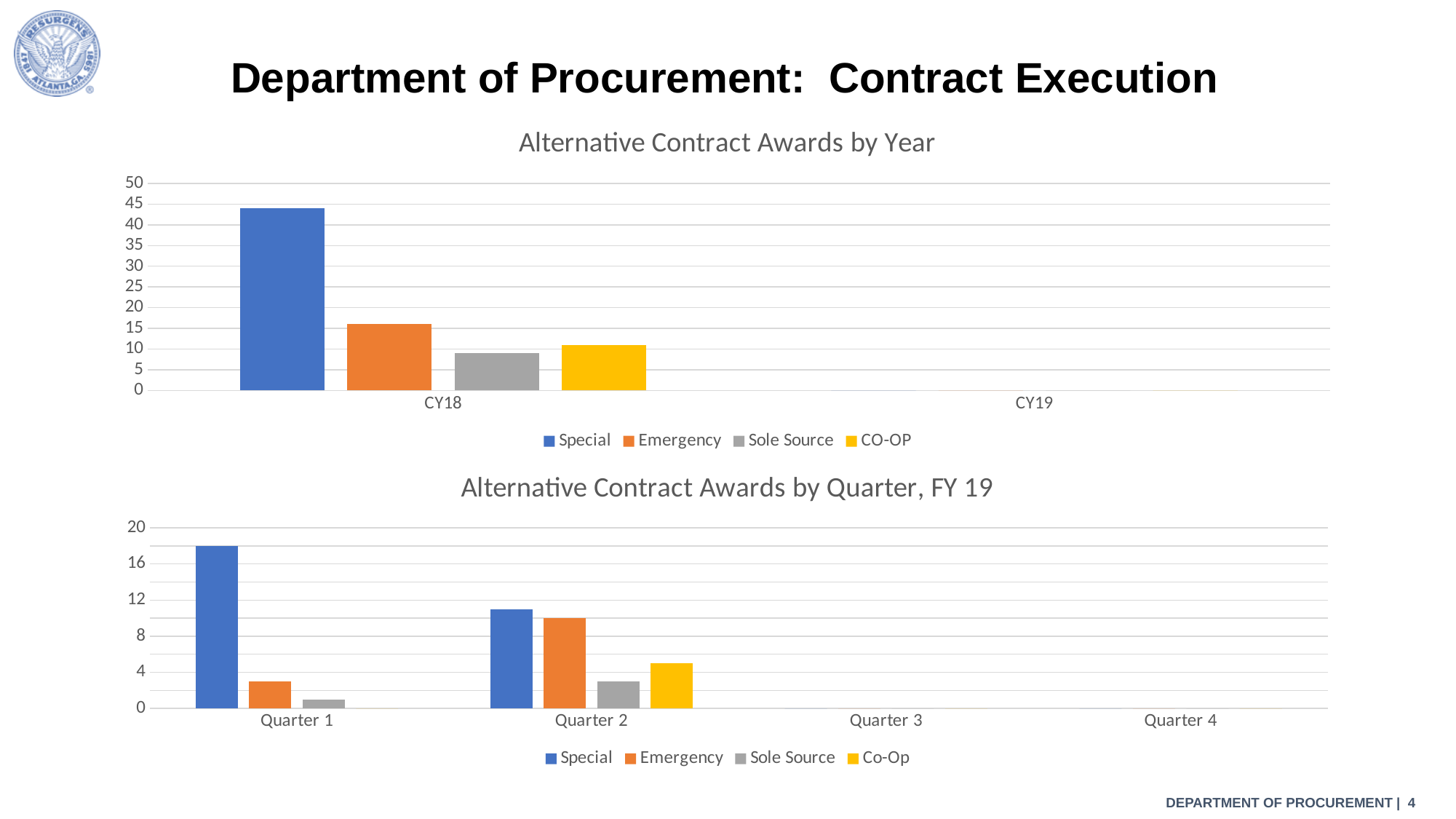
In the 'Alternative Contract Awards by Year' chart, what are the two categories on the x axis? CY18 and CY19 In the 'Alternative Contract Awards by Year' chart, how many series does the legend list? 4 In the 'Alternative Contract Awards by Quarter, FY 19' chart, how many quarters are shown on the x axis? 4 In the 'Alternative Contract Awards by Year' chart, which series has the highest value for CY18? Special What type of chart is 'Alternative Contract Awards by Quarter, FY 19'? Bar chart In the 'Alternative Contract Awards by Year' chart, is the value for Special in CY18 greater or less than 40? greater In the 'Alternative Contract Awards by Quarter, FY 19' chart, which is larger: Special in Quarter 1 or Special in Quarter 2? Special in Quarter 1 In the 'Alternative Contract Awards by Quarter, FY 19' chart, which series has the highest value in Quarter 1? Special In the 'Alternative Contract Awards by Quarter, FY 19' chart, is the value for Co-Op in Quarter 2 greater or less than 8? less In the 'Alternative Contract Awards by Quarter, FY 19' chart, is the value for Special in Quarter 1 greater or less than 16? greater In the 'Alternative Contract Awards by Year' chart, which series has the lowest value for CY18? Sole Source